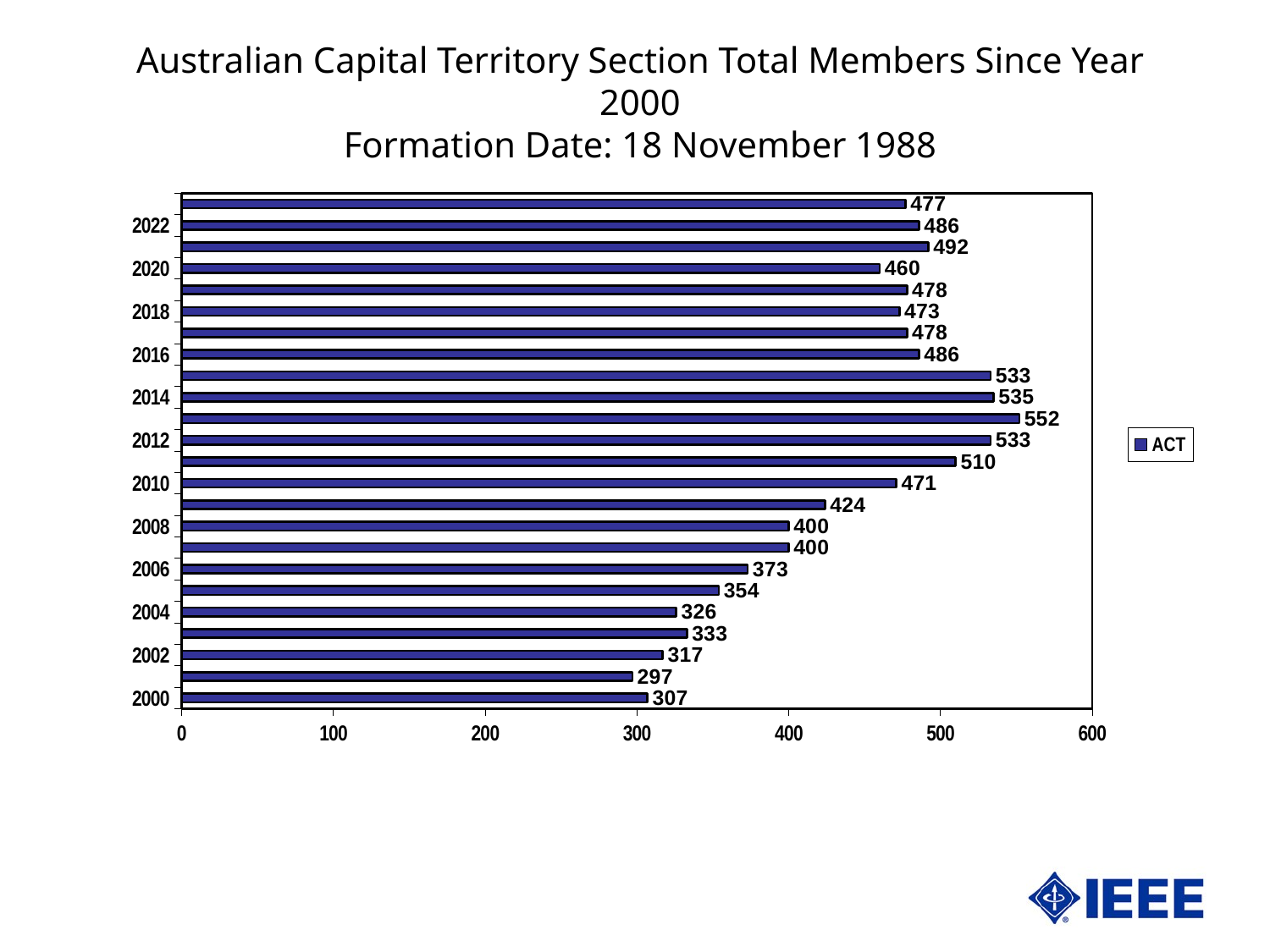
What was the total number of ACT Section members in 2022? 486 What was the total number of ACT Section members in 2020? 460 How many bars are plotted on the chart? 24 Which year had more members, 2014 or 2016? 2014 What was the total number of ACT Section members in 2000? 307 What type of chart is shown on the slide? bar chart What series name is shown in the legend? ACT What was the total number of ACT Section members in 2012? 533 What is the lowest member count shown on the chart? 297 What is the difference in members between 2010 and 2000? 164 Is the value for 2008 greater or less than 500? less What is the highest member count shown on the chart? 552